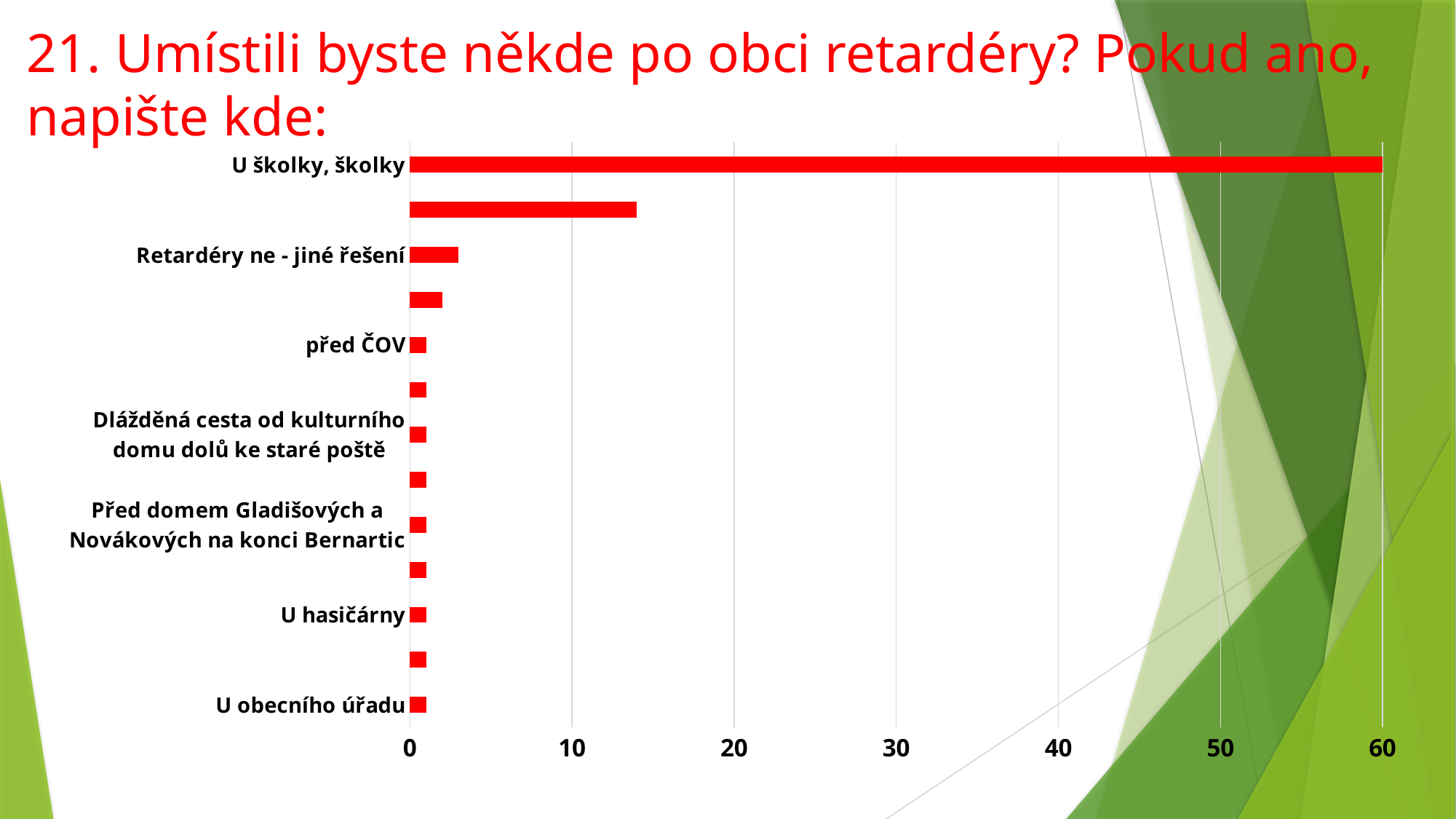
Which category has the highest value? U školky, školky Which is larger, the value for U školky, školky or the value for U obecního úřadu? U školky, školky How many bars are plotted in the chart? 13 Which is larger, the value for U školky, školky or the value for Retardéry ne - jiné řešení? U školky, školky Is the value for U školky, školky greater or less than 50? greater What colour are the bars in the chart? red Is the value for U hasičárny greater or less than 10? less Which is larger, the value for Retardéry ne - jiné řešení or the value for před ČOV? Retardéry ne - jiné řešení What kind of chart is shown on the slide? bar chart What is the value for U školky, školky? 60 Is the value for Retardéry ne - jiné řešení greater or less than 10? less What is the highest value shown on the horizontal axis? 60